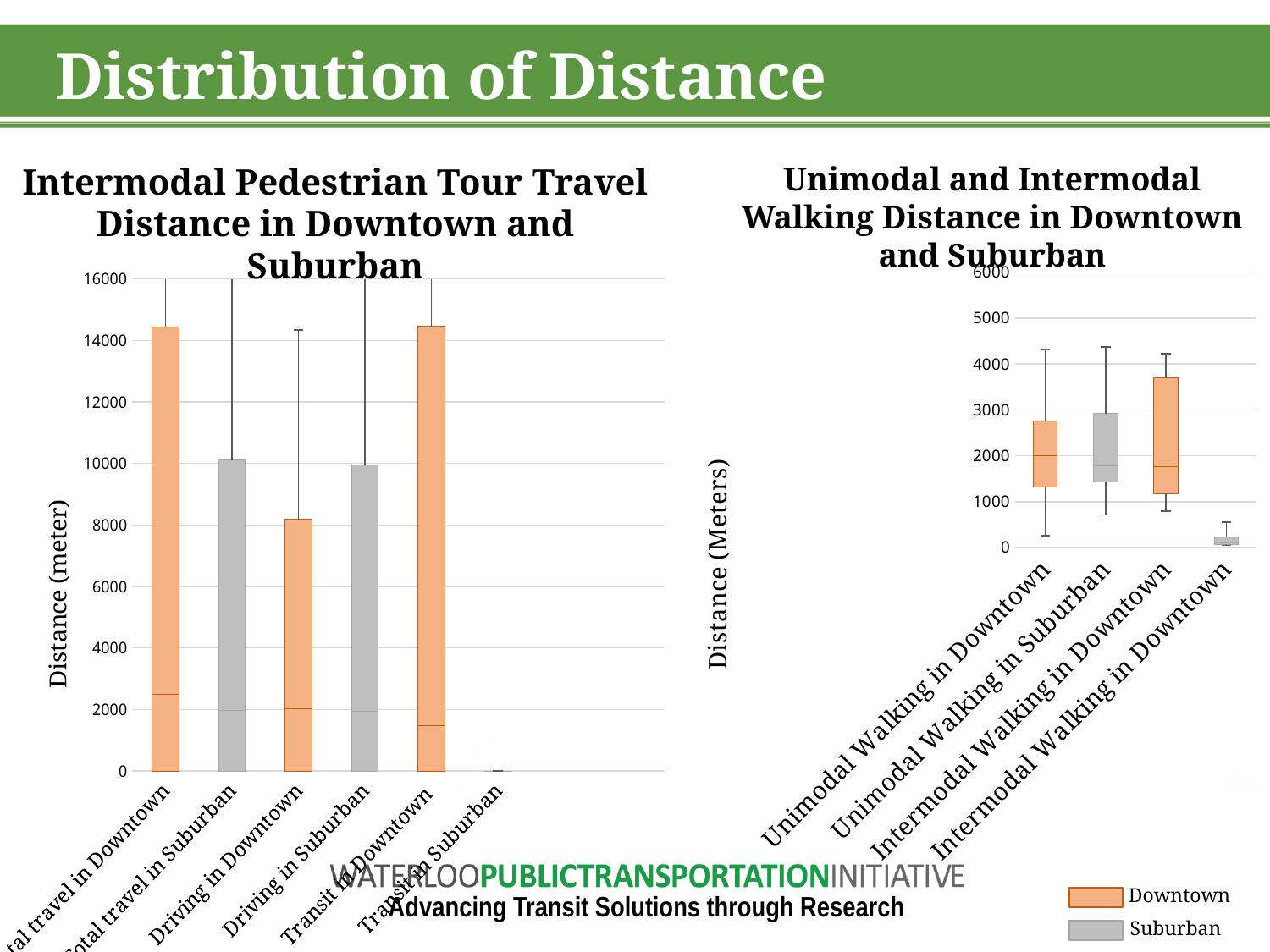
In the legend, which series is shown in orange? Downtown What kind of chart is the left chart, 'Intermodal Pedestrian Tour Travel Distance in Downtown and Suburban'? Box-and-whisker plot In the right chart, which category has the lowest box? Intermodal Walking in Downtown (fourth category) What is the y-axis title of the right chart, 'Unimodal and Intermodal Walking Distance in Downtown and Suburban'? Distance (Meters) How many categories are shown on the x axis of the left chart, 'Intermodal Pedestrian Tour Travel Distance in Downtown and Suburban'? 6 How many entries does the legend at the bottom right of the slide list? 2 In the right chart, is the top of the upper whisker for 'Unimodal Walking in Downtown' greater or less than 4000? greater In the left chart, is the top of the box for 'Transit in Downtown' greater or less than 14000? greater How many categories are shown on the x axis of the right chart, 'Unimodal and Intermodal Walking Distance in Downtown and Suburban'? 4 In the left chart, which has the higher top of box: 'Driving in Downtown' or 'Driving in Suburban'? Driving in Suburban In the left chart, is the top of the box for 'Driving in Downtown' greater or less than 10000? less